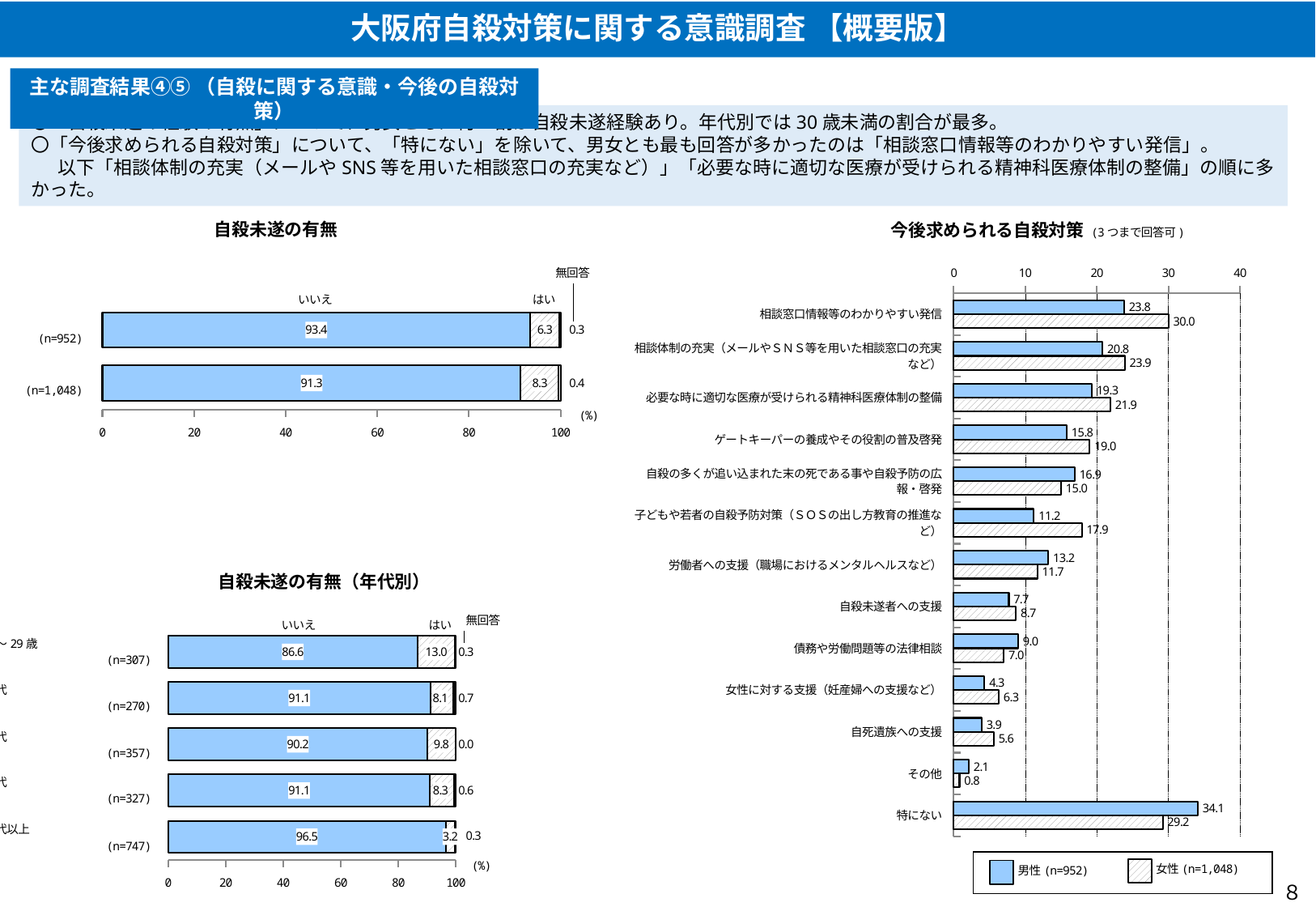
In the chart titled 今後求められる自殺対策, how many categories are shown? 13 In the chart titled 今後求められる自殺対策, what is the value for 男性 for 相談窓口情報等のわかりやすい発信? 23.8 In the chart titled 今後求められる自殺対策, how many series does the legend list? 2 In the chart titled 自殺未遂の有無（年代別）, which row has the highest はい value? (n=307) In the chart titled 今後求められる自殺対策, which category has the lowest value for 女性? その他 What kind of chart is 自殺未遂の有無（年代別）? Stacked bar chart In the chart titled 今後求められる自殺対策, what is the value for 女性 for 特にない? 29.2 In the chart titled 今後求められる自殺対策, which category has the highest value for 男性? 特にない In the chart titled 今後求められる自殺対策, which is larger for 自殺の多くが追い込まれた末の死である事や自殺予防の広報・啓発, the 男性 value or the 女性 value? 男性 In the chart titled 自殺未遂の有無, what is the はい value for the (n=1,048) row? 8.3 In the chart titled 自殺未遂の有無, what is the いいえ value for the (n=952) row? 93.4 In the chart titled 今後求められる自殺対策, what is the difference between the 女性 and 男性 values for 子どもや若者の自殺予防対策（ＳＯＳの出し方教育の推進など）? 6.7